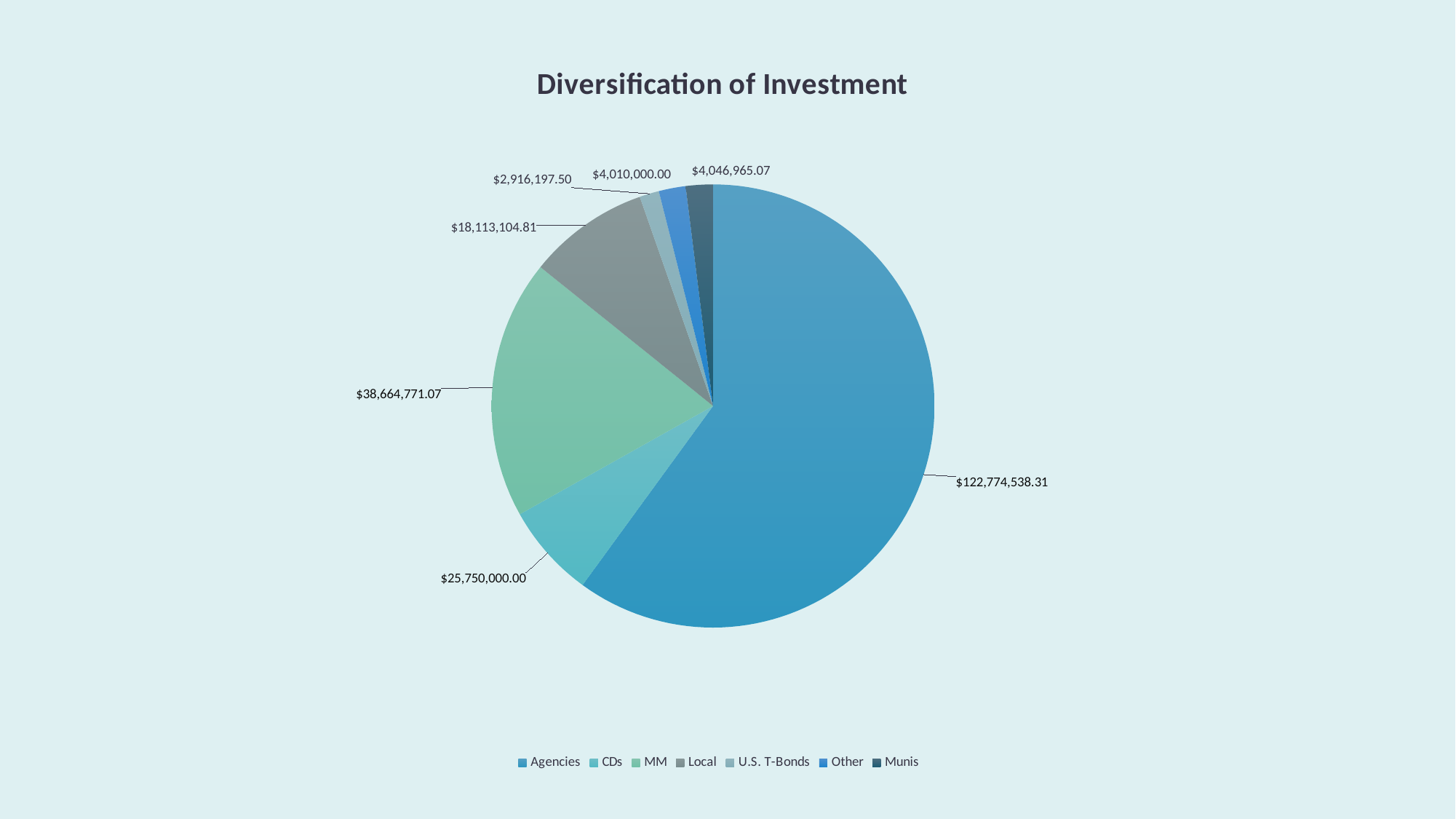
Which is larger, the Other slice or the Munis slice? Munis What is the value of the MM slice? $38,664,771.07 Which category has the largest slice? Agencies Which category has the smallest slice? U.S. T-Bonds What is the value of the Local slice? $18,113,104.81 What is the total of all slices in the pie chart? $216,275,576.76 How many slices does the pie chart have? 7 What is the value of the Agencies slice? $122,774,538.31 What is the title of the chart? Diversification of Investment What type of chart is shown on the slide? Pie chart What is the value of the U.S. T-Bonds slice? $2,916,197.50 What is the difference between the MM value and the CDs value? $12,914,771.07